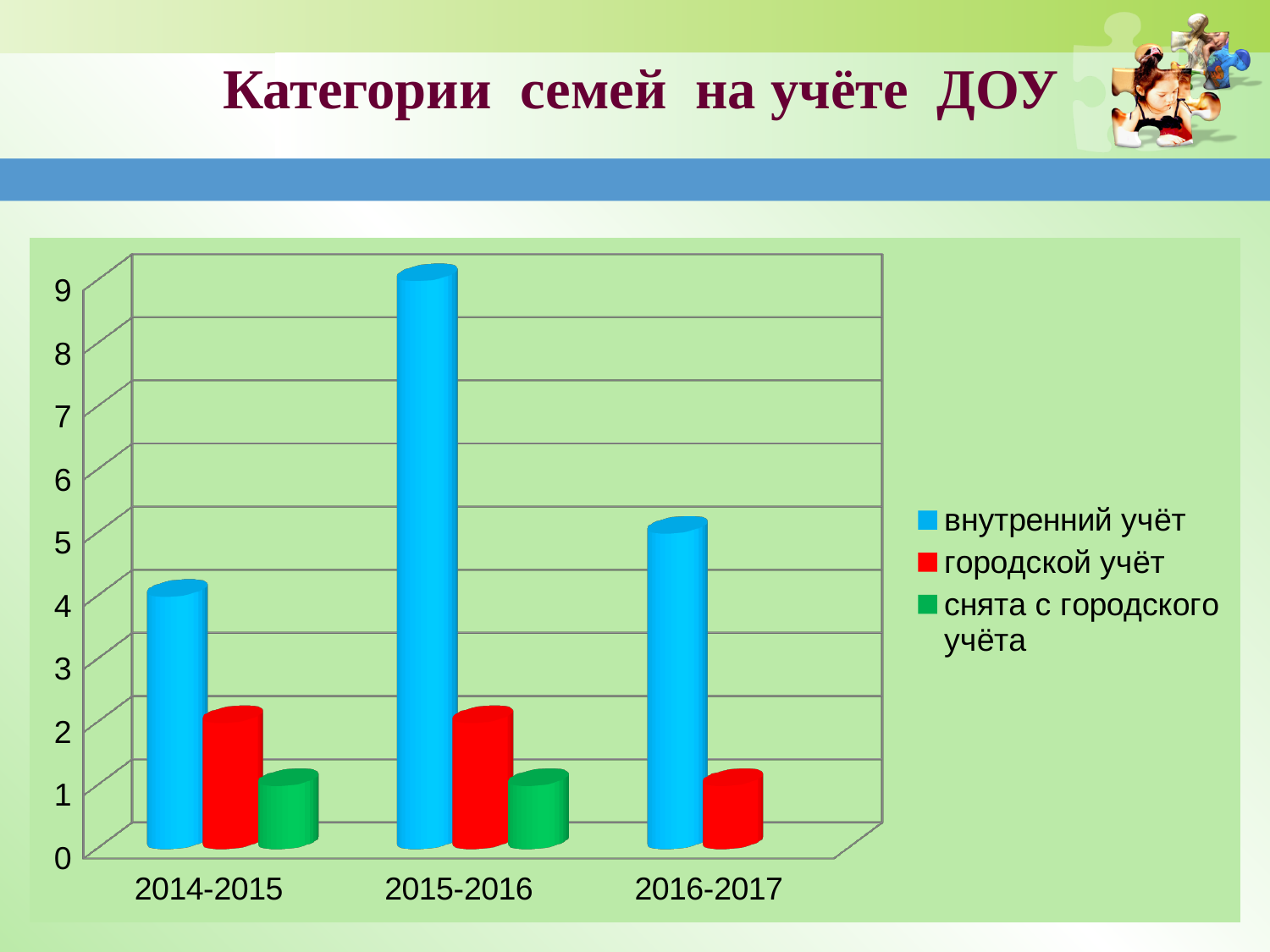
In which year category is the value for 'внутренний учёт' the lowest? 2014-2015 What kind of chart is shown on the slide? bar chart Is the value for 'внутренний учёт' in 2016-2017 greater or less than 6? less Is the value for 'внутренний учёт' in 2014-2015 greater or less than 3? greater Which series has the lowest value in 2014-2015? снята с городского учёта Which colour represents the series 'городской учёт' in the legend? red How many year categories are shown on the x axis? 3 What is the title of the slide? Категории семей на учёте ДОУ Is the value for 'внутренний учёт' in 2015-2016 greater or less than 8? greater Which is larger in 2016-2017: 'внутренний учёт' or 'городской учёт'? внутренний учёт In which year category is the value for 'внутренний учёт' the highest? 2015-2016 How many series does the legend list? 3